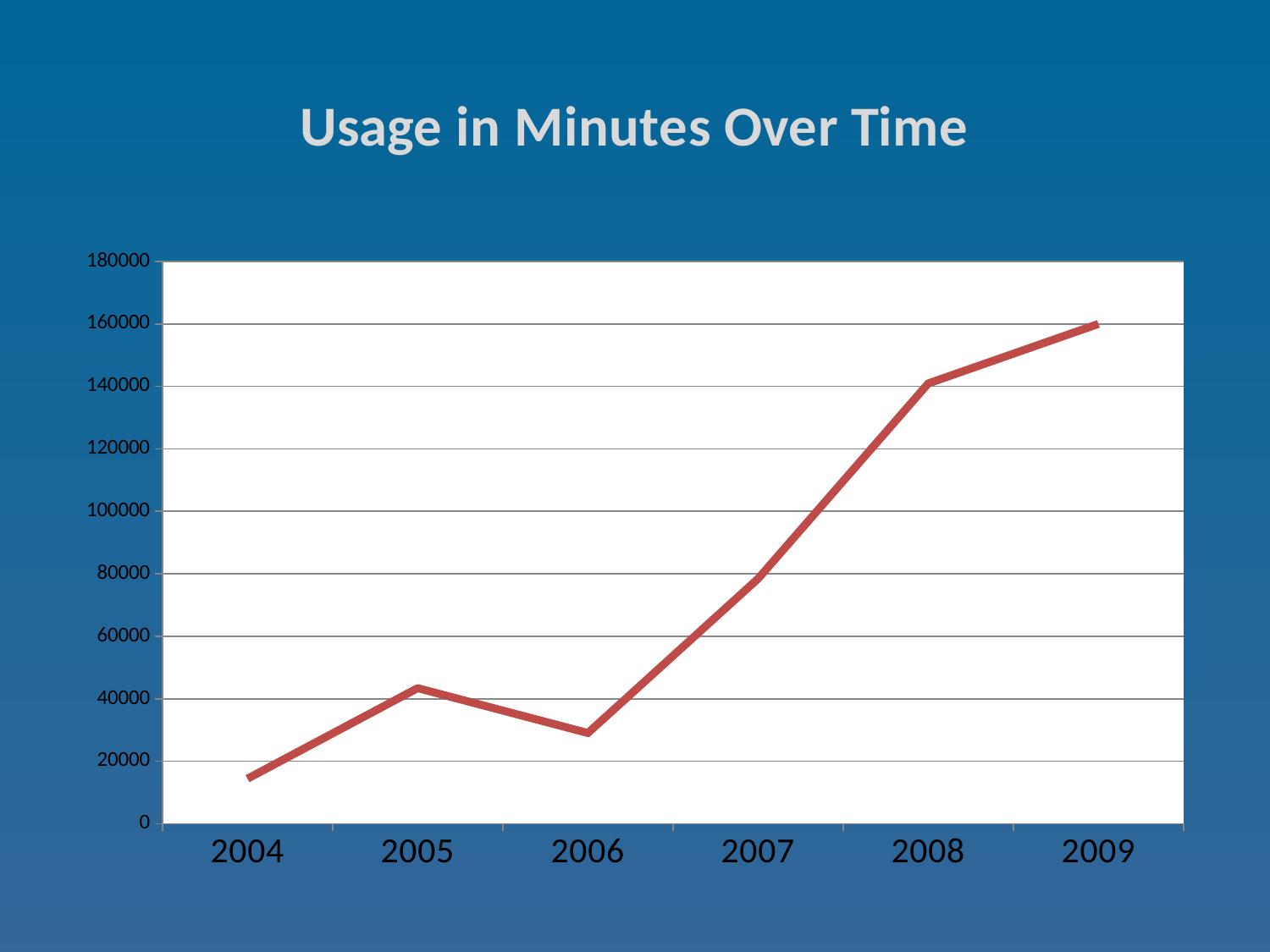
Which year has the larger value, 2005 or 2006? 2005 Is the value for 2007 greater or less than 60000? greater Which year has the lowest usage in minutes? 2004 Is the value for 2004 greater or less than 20000? less Does usage rise or fall between 2006 and 2009? rise What is the title of the chart? Usage in Minutes Over Time Is the value for 2008 greater or less than 120000? greater Which year has the larger value, 2007 or 2008? 2008 What kind of chart is shown on the slide? line chart How many years are plotted on the x axis? 6 Which year has the highest usage in minutes? 2009